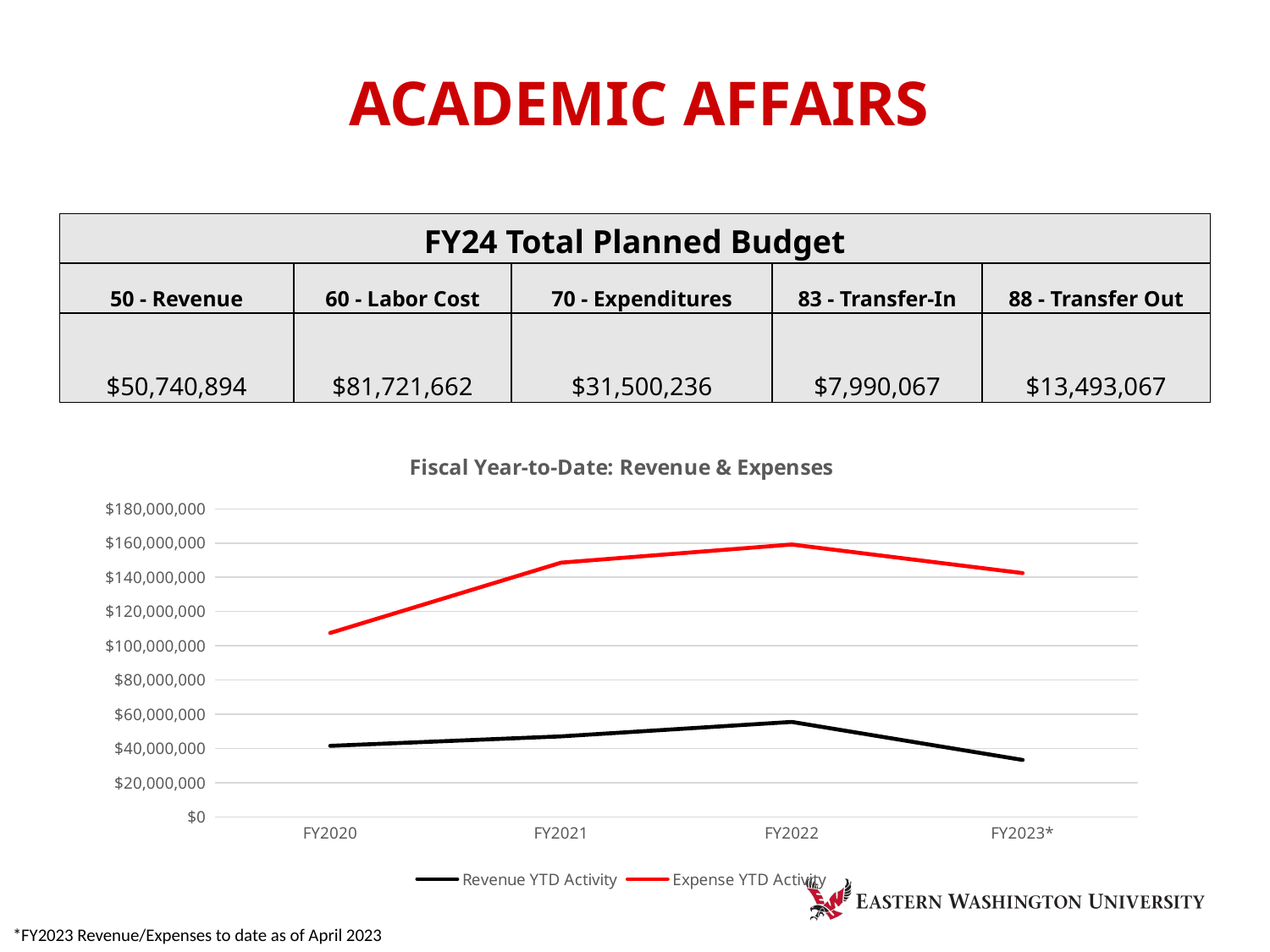
In the line chart, which is larger for FY2021: Revenue YTD Activity or Expense YTD Activity? Expense YTD Activity How many series does the legend of the line chart list? 2 In the line chart, is the Revenue YTD Activity for FY2022 greater or less than $60,000,000? less What kind of chart is shown under the title "Fiscal Year-to-Date: Revenue & Expenses"? Line chart How many fiscal years are plotted along the x axis of the line chart? 4 In the line chart, is the Expense YTD Activity for FY2020 greater or less than $120,000,000? less In the line chart, which fiscal year has the lowest Expense YTD Activity? FY2020 In the line chart, is the Expense YTD Activity for FY2021 greater or less than $140,000,000? greater In the line chart, what colour is the Expense YTD Activity line? Red In the line chart, which fiscal year has the highest Expense YTD Activity? FY2022 In the line chart, which fiscal year has the lowest Revenue YTD Activity? FY2023*